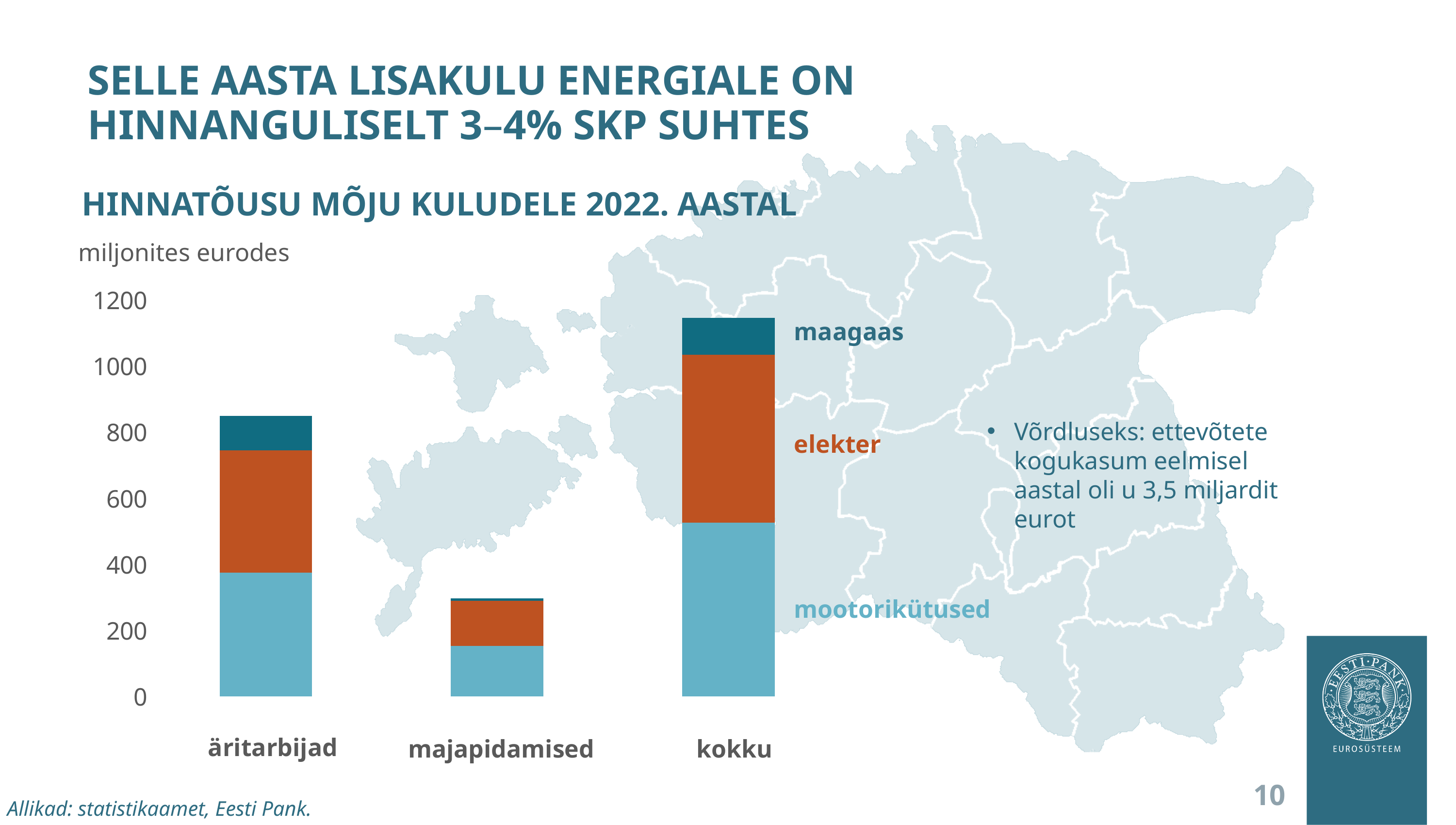
How many series does the chart's legend list? 3 What kind of chart is shown on the slide? Stacked bar chart Which category has the lowest total bar? majapidamised Is the total value for äritarbijad greater or less than 1000? less What is the title of the chart? HINNATÕUSU MÕJU KULUDELE 2022. AASTAL Is the total value for kokku greater or less than 1000? greater How many categories are shown on the x axis of the chart? 3 Which total is larger, äritarbijad or majapidamised? äritarbijad Is the total value for majapidamised greater or less than 200? greater In what unit are the chart's values expressed? miljonites eurodes Which category has the highest total bar? kokku